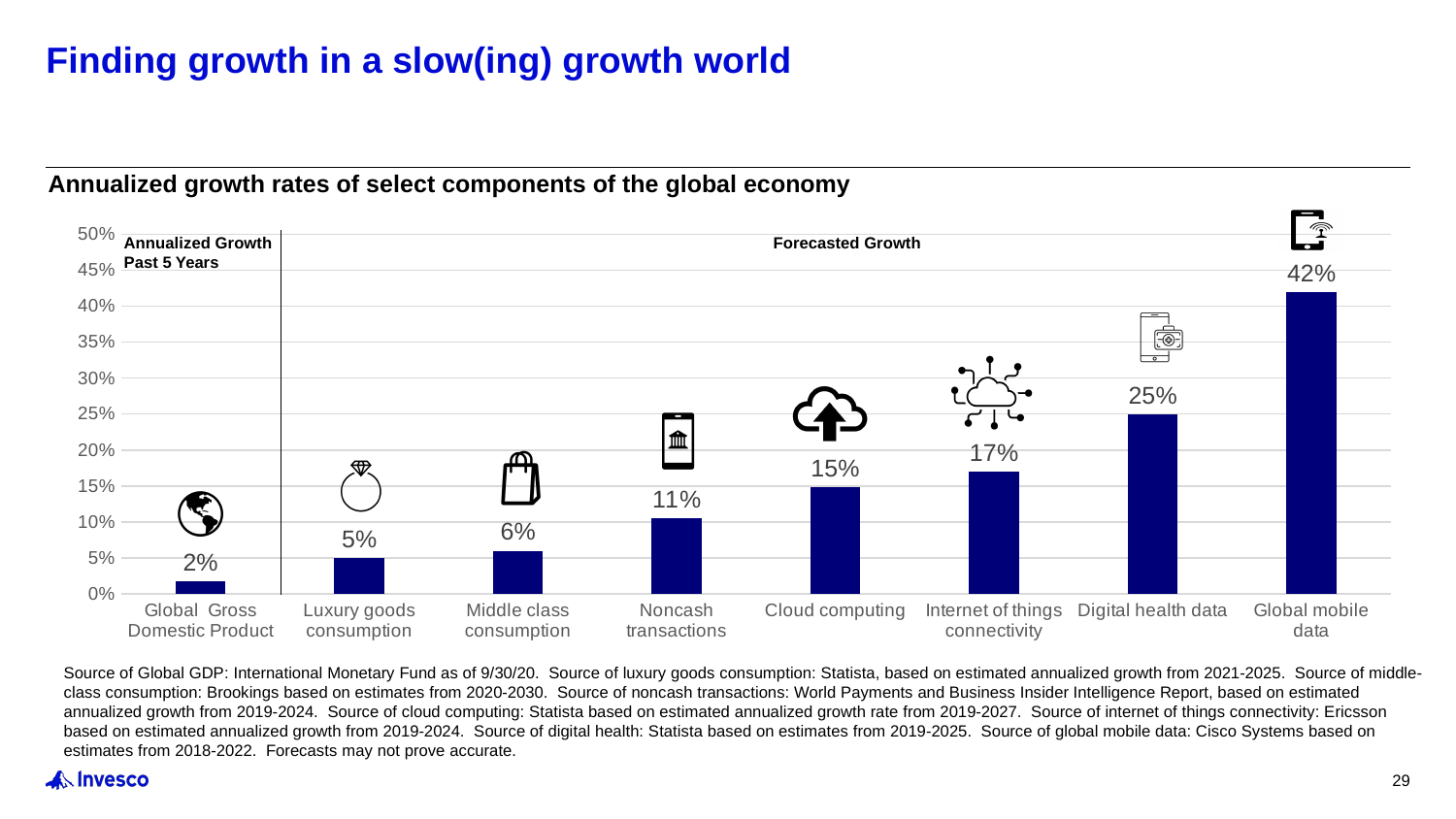
What is the difference between the growth rates for Digital health data and Internet of things connectivity? 8% What is the annualized growth rate shown for Global Gross Domestic Product? 2% What kind of chart is shown on the slide? Bar chart What is the annualized growth rate shown for Global mobile data? 42% What is the annualized growth rate shown for Cloud computing? 15% Do the values rise or fall moving from left to right along the x axis? Rise How many categories are shown on the chart? 8 Which category has the highest annualized growth rate? Global mobile data What is the title of the chart? Annualized growth rates of select components of the global economy Which has a higher growth rate, Noncash transactions or Middle class consumption? Noncash transactions Which category has the lowest annualized growth rate? Global Gross Domestic Product Is the value for Digital health data greater or less than 20%? greater